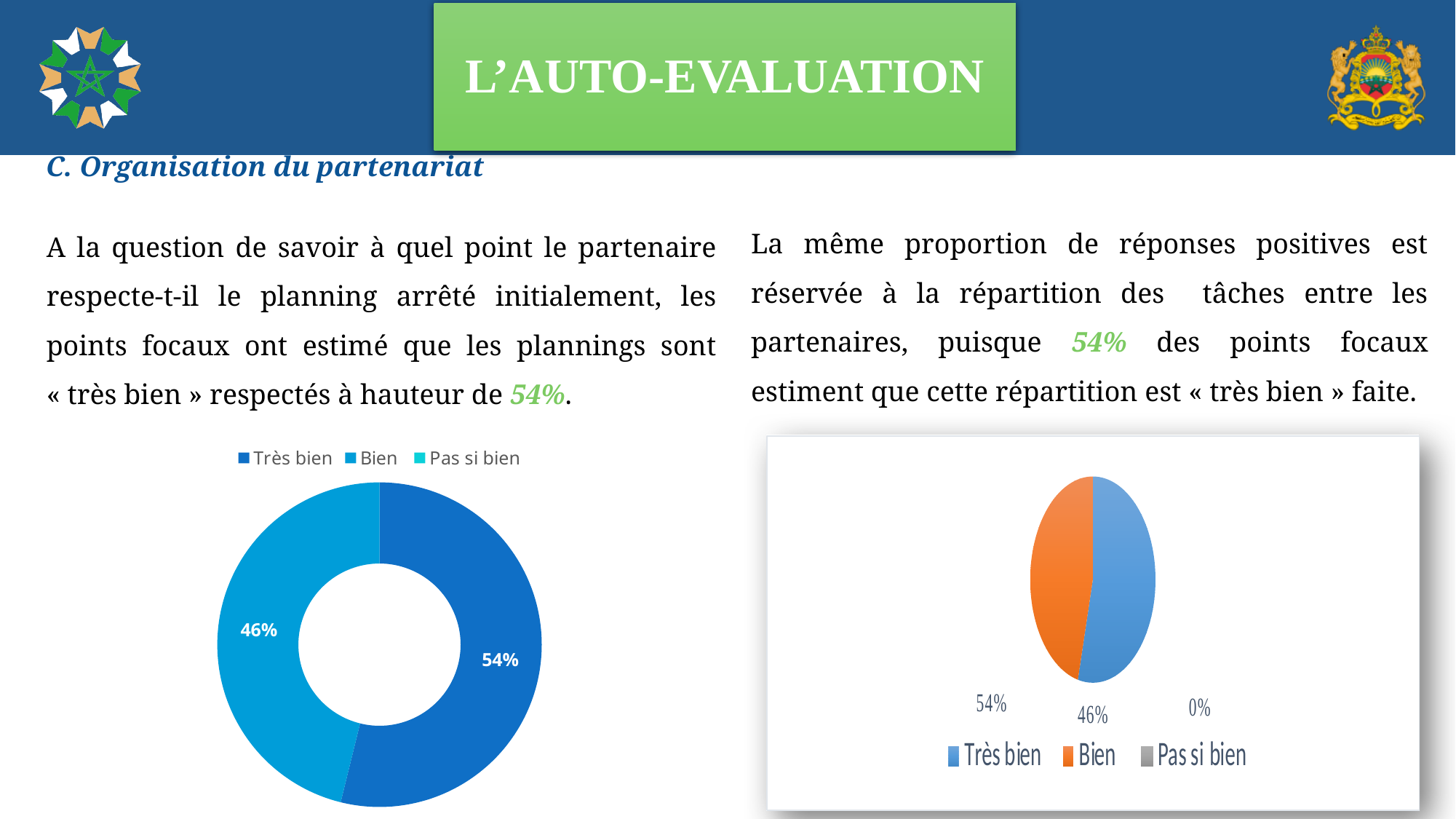
On the right chart, what is the value for Bien? 46% On the right chart, what is the value for Très bien? 54% What kind of chart is the left chart? Doughnut chart What kind of chart is the right chart? Pie chart On the right chart, what is the value for Pas si bien? 0% On the left chart, what is the value for Très bien? 54% On the right chart, which is larger, Très bien or Bien? Très bien On the left chart, how many entries does the legend list? 3 On the right chart, which category has the smallest share? Pas si bien On the left chart, what is the value for Bien? 46% On the left chart, which category has the largest share? Très bien On the left chart, what is the difference between the Très bien and Bien shares? 8%